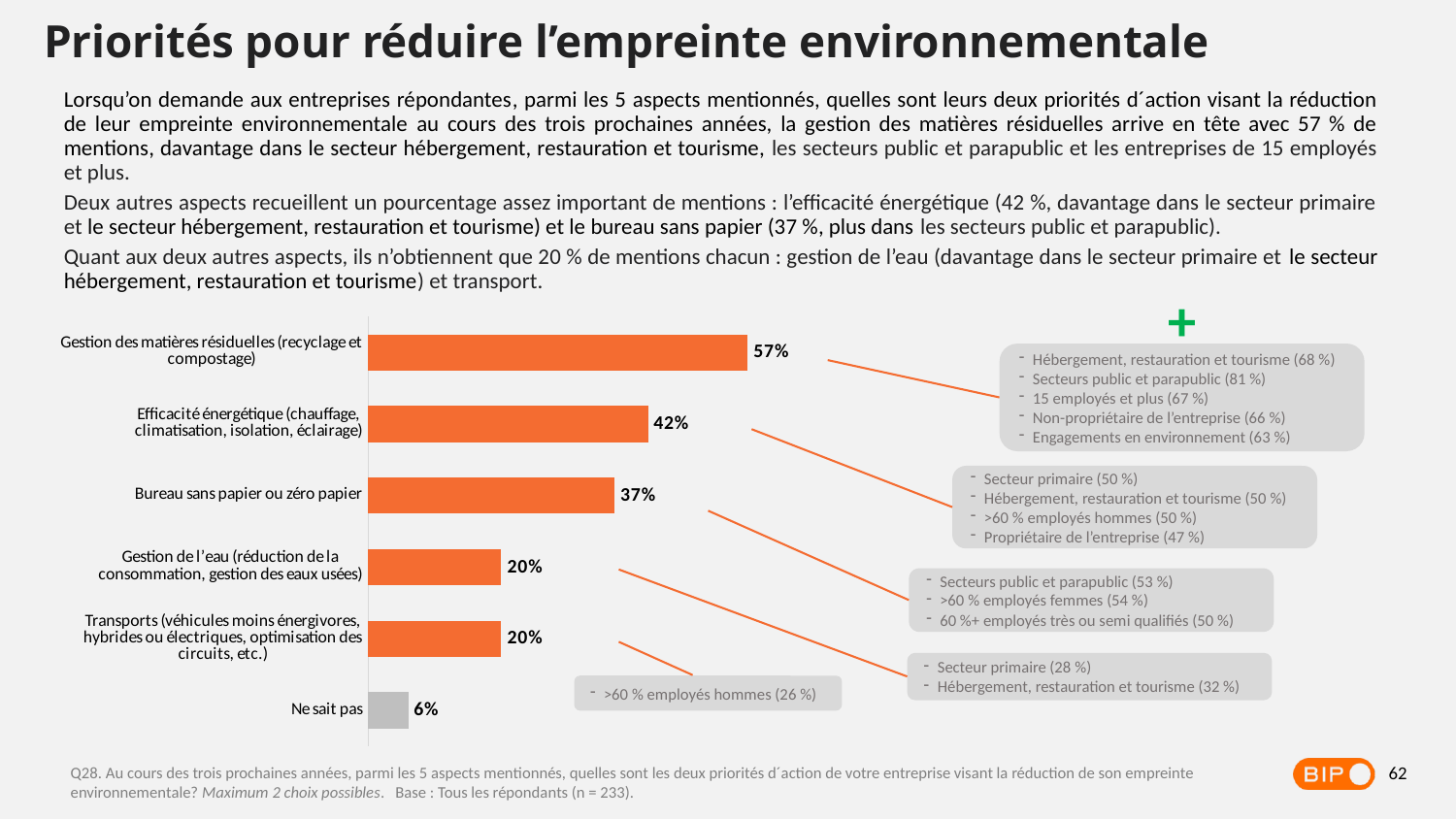
What is the value for "Efficacité énergétique (chauffage, climatisation, isolation, éclairage)"? 42% Which category has the lowest value? Ne sait pas What is the difference between the values for "Bureau sans papier ou zéro papier" and "Gestion de l'eau"? 17% What is the difference between the values for "Gestion des matières résiduelles" and "Efficacité énergétique"? 15% Do the values for "Gestion de l'eau" and "Transports" have the same value? Yes, both 20% How many categories are shown in the chart? 6 Which category has the highest value? Gestion des matières résiduelles (recyclage et compostage) What kind of chart is shown on the slide? Bar chart What is the value for "Gestion des matières résiduelles (recyclage et compostage)"? 57% Which is larger, the value for "Efficacité énergétique" or the value for "Bureau sans papier ou zéro papier"? Efficacité énergétique What is the value for "Ne sait pas"? 6% What is the value for "Bureau sans papier ou zéro papier"? 37%